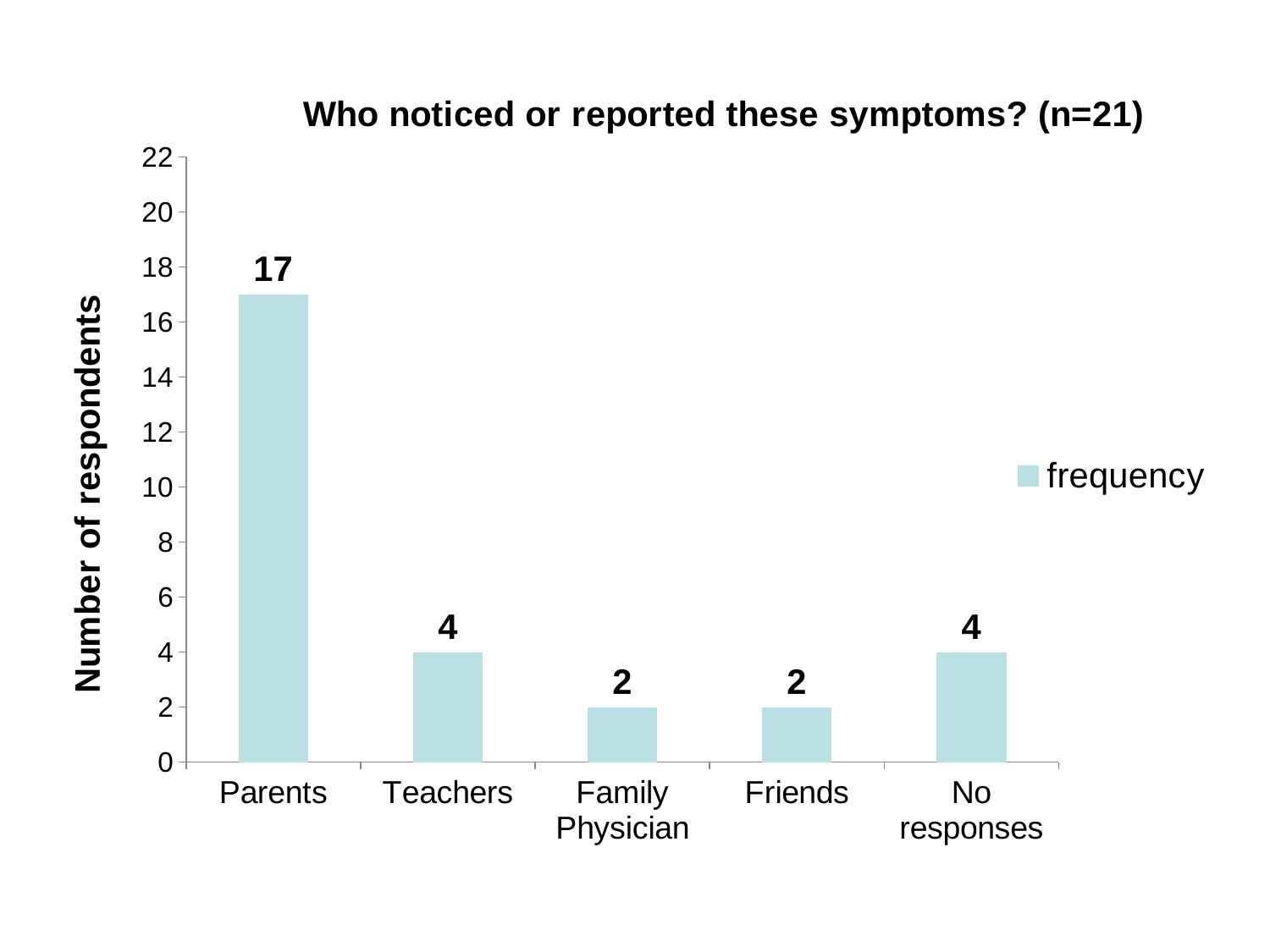
What is the title of the chart? Who noticed or reported these symptoms? (n=21) What is the value for Teachers? 4 Which is larger, the value for Teachers or the value for Friends? Teachers Which category has the highest value? Parents How many categories are shown on the x axis? 5 What is the difference between the values for Parents and Teachers? 13 What is the value for No responses? 4 Is the value for Parents greater or less than 10? greater What is the value for Family Physician? 2 What kind of chart is shown? bar chart How many series does the legend list? 1 What is the value for Parents? 17